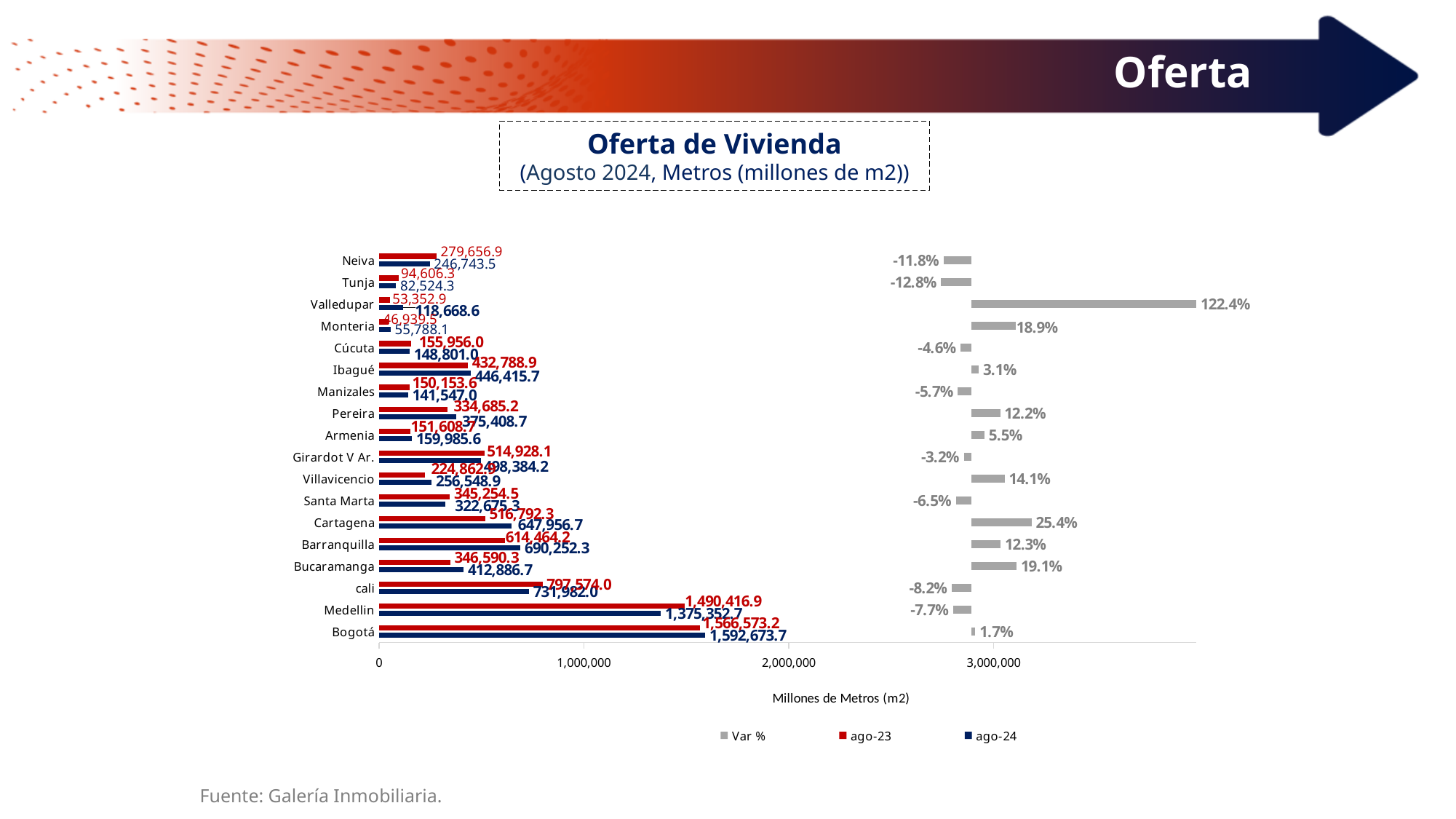
Which is larger for Bucaramanga, the ago-23 value or the ago-24 value? ago-24 Which city has the highest ago-24 value? Bogotá Is the ago-23 value for cali greater or less than 1,000,000? less Which city has the lowest Var % value? Tunja What is the ago-24 value for Bogotá? 1,592,673.7 How many series does the legend list? 3 What kind of chart is shown on the slide? bar chart How many cities are shown on the chart? 18 Which city has the highest Var % value? Valledupar What is the difference between the ago-24 and ago-23 values for Barranquilla? 75,788.1 What is the ago-23 value for Medellin? 1,490,416.9 What is the Var % value for Cartagena? 25.4%